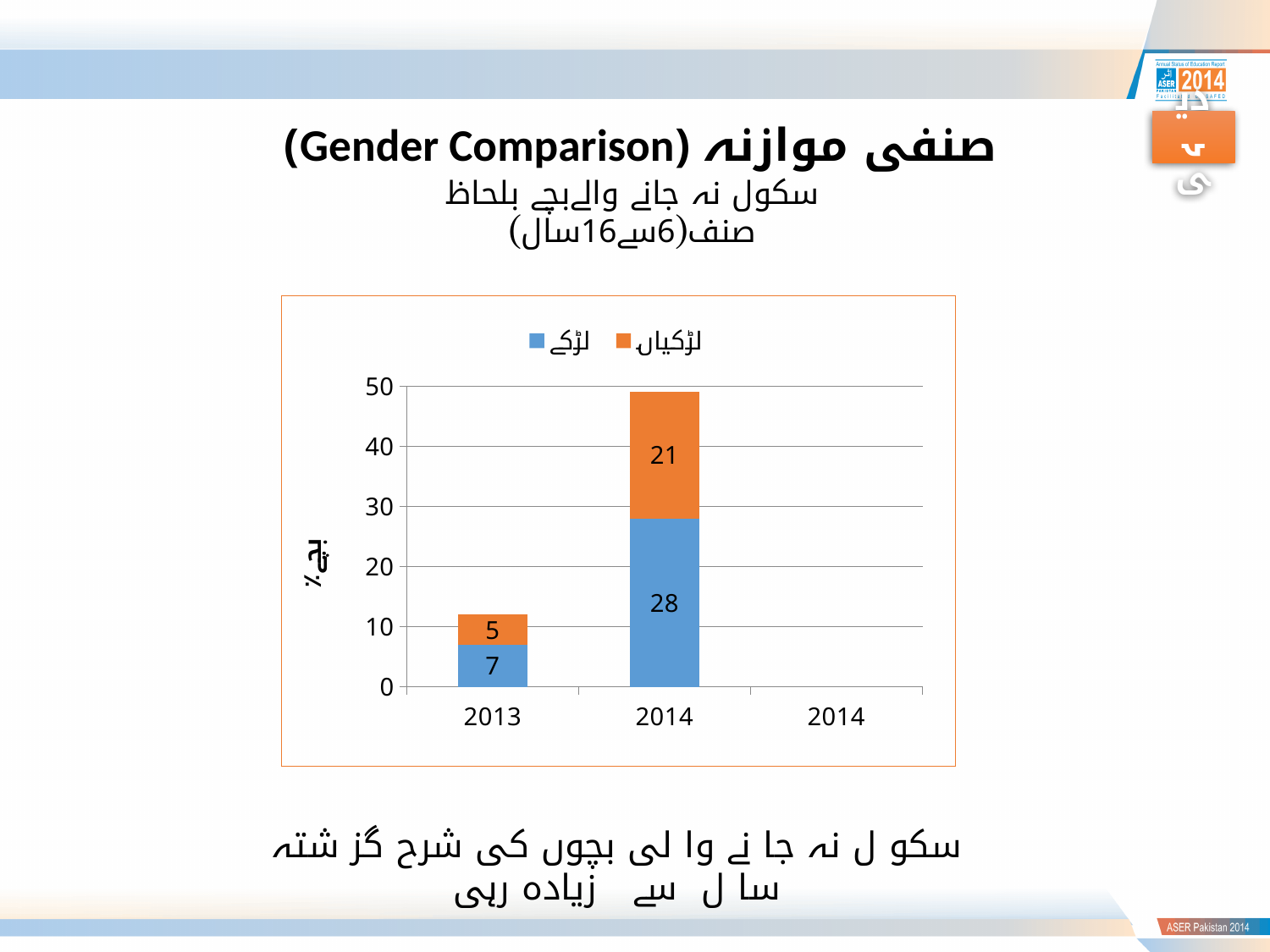
What is the value for لڑکے (boys) in 2014? 28 What is the value for لڑکیاں (girls) in 2013? 5 What is the total of the stacked bar for 2013? 12 Which is larger in 2014, the value for لڑکے (boys) or for لڑکیاں (girls)? لڑکے (boys) How many series does the legend list? 2 What is the total of the stacked bar for 2014? 49 Does the total of the stacked bars rise or fall from 2013 to 2014? rise Which colour represents لڑکیاں (girls) in the chart? orange What type of chart is shown on the slide? stacked bar chart What is the difference between the لڑکے (boys) values for 2014 and 2013? 21 What is the value for لڑکیاں (girls) in 2014? 21 What is the value for لڑکے (boys) in 2013? 7